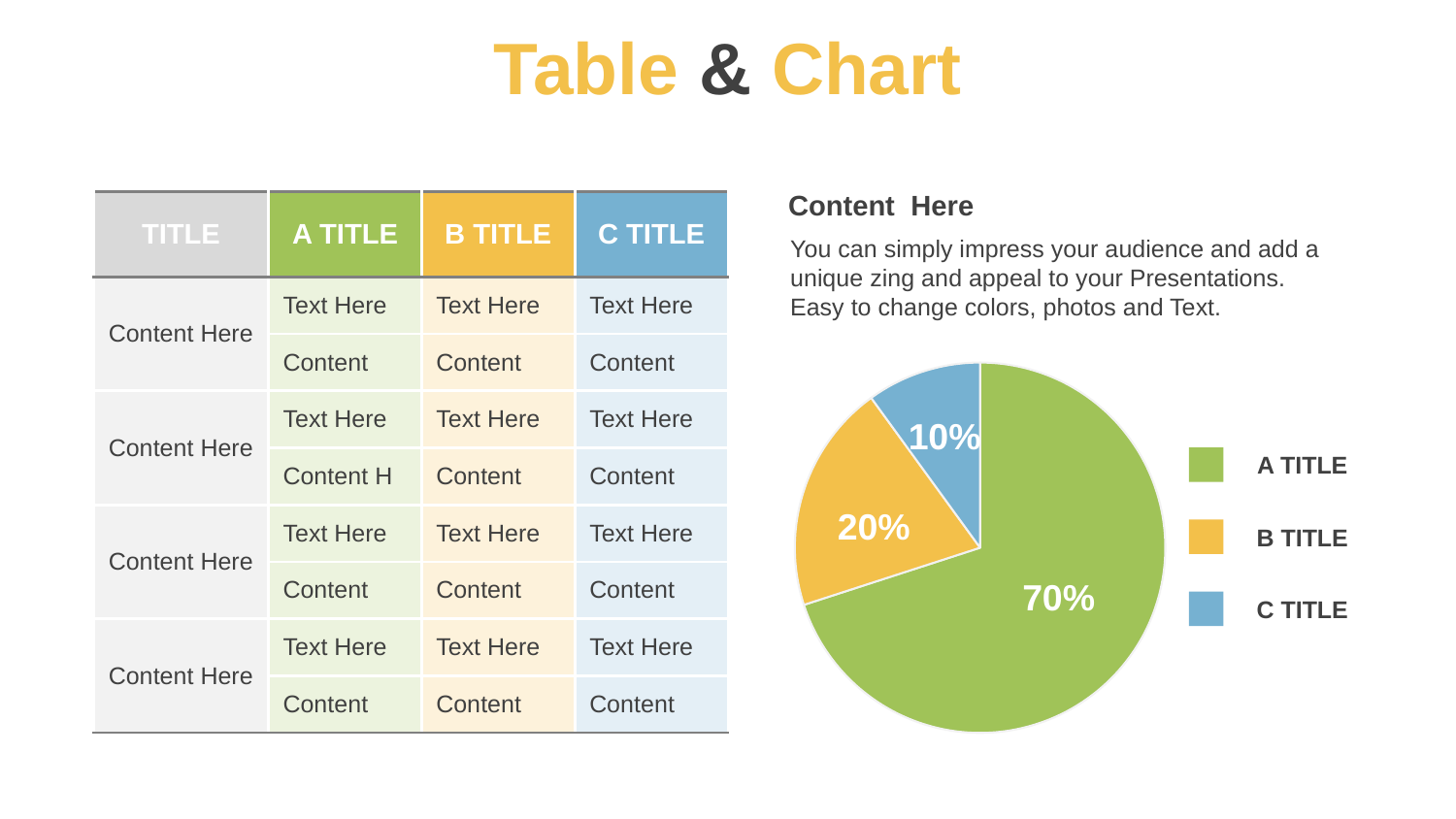
What colour is the A TITLE slice in the pie chart? green What share of the pie chart does C TITLE have? 10% How many slices does the pie chart have? 3 What share of the pie chart does A TITLE have? 70% What colour is the C TITLE slice in the pie chart? blue Which category has the largest slice in the pie chart? A TITLE How many entries does the pie chart legend list? 3 What kind of chart is shown on the slide? pie chart Which category has the smallest slice in the pie chart? C TITLE Which slice is larger in the pie chart, B TITLE or C TITLE? B TITLE What is the difference in percentage points between the A TITLE and B TITLE slices? 50 What share of the pie chart does B TITLE have? 20%